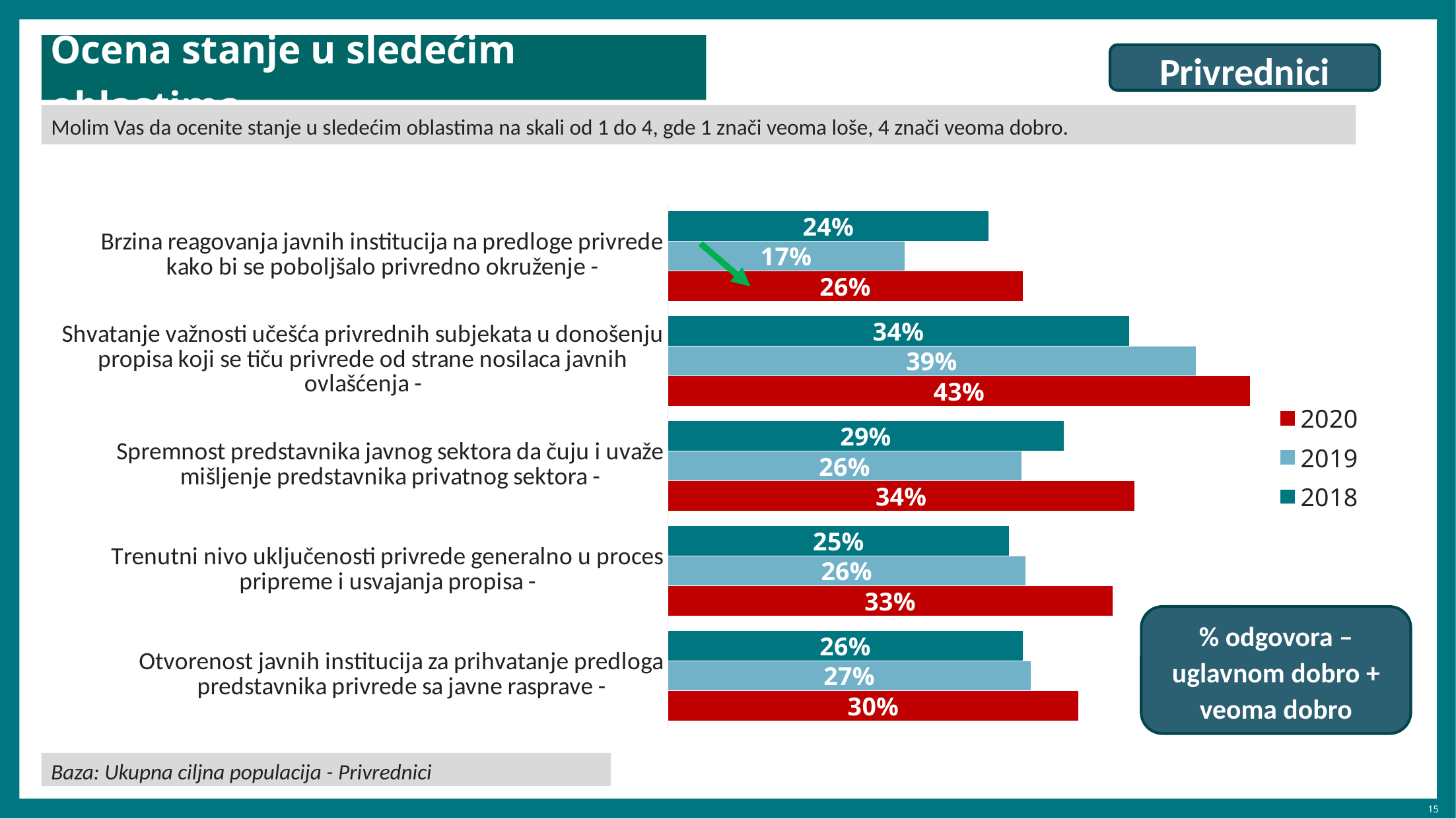
For "Trenutni nivo uključenosti privrede generalno u proces pripreme i usvajanja propisa", which year has the larger value, 2018 or 2020? 2020 Which category has the lowest 2019 value? Brzina reagovanja javnih institucija na predloge privrede kako bi se poboljšalo privredno okruženje What is the 2020 value for "Otvorenost javnih institucija za prihvatanje predloga predstavnika privrede sa javne rasprave"? 30% What is the 2018 value for "Spremnost predstavnika javnog sektora da čuju i uvaže mišljenje predstavnika privatnog sektora"? 29% What is the 2020 value for "Shvatanje važnosti učešća privrednih subjekata u donošenju propisa koji se tiču privrede od strane nosilaca javnih ovlašćenja"? 43% Which category has the highest 2020 value? Shvatanje važnosti učešća privrednih subjekata u donošenju propisa koji se tiču privrede od strane nosilaca javnih ovlašćenja What is the difference between the 2020 and 2019 values for "Brzina reagovanja javnih institucija na predloge privrede kako bi se poboljšalo privredno okruženje"? 9 percentage points What type of chart is shown on the slide? Bar chart How many categories are shown in the chart? 5 What is the 2019 value for "Brzina reagovanja javnih institucija na predloge privrede kako bi se poboljšalo privredno okruženje"? 17% How many series does the legend list? 3 Which colour represents the 2020 series in the chart? Red